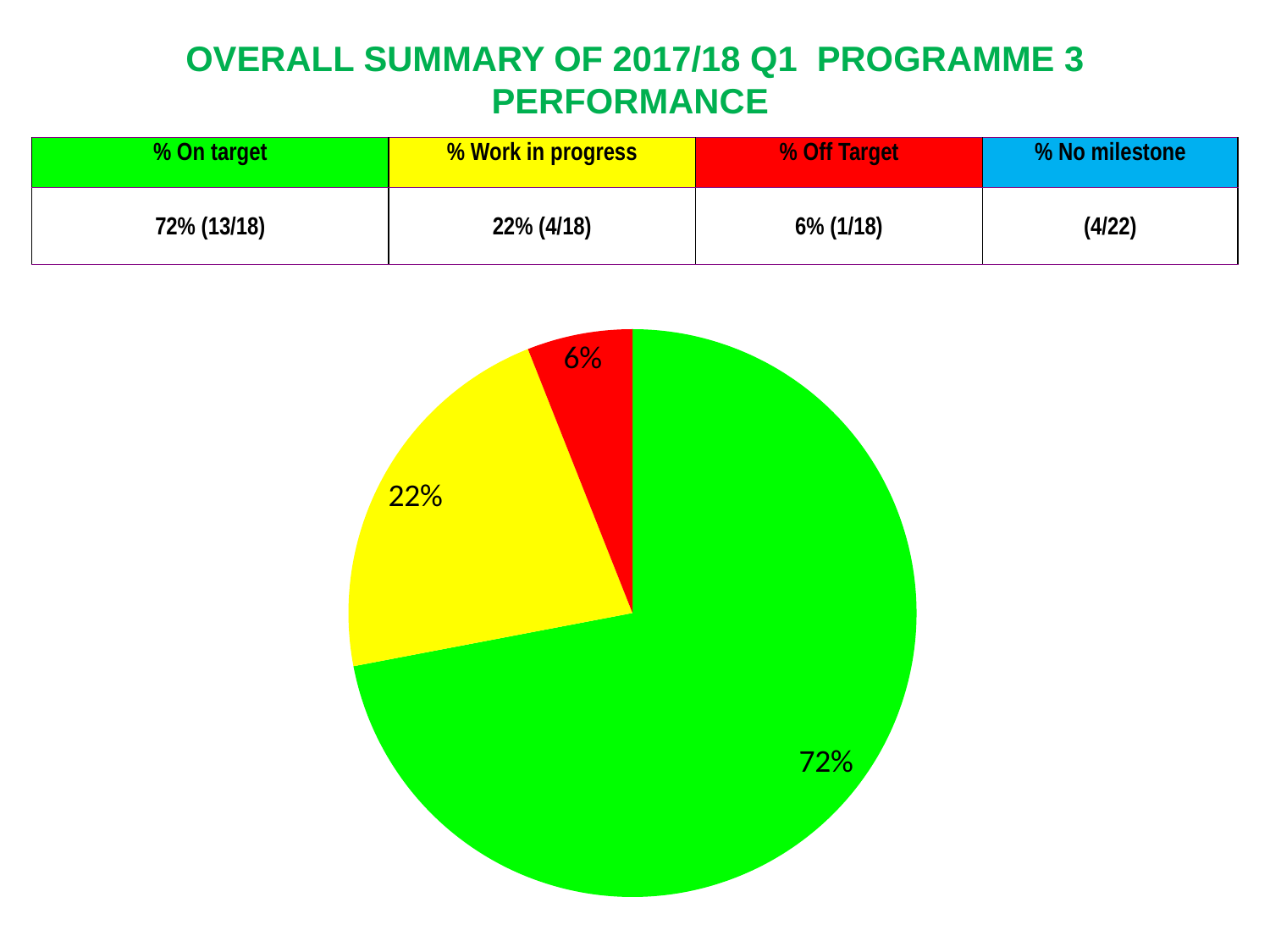
What share of the pie does the red slice represent? 6% What is the difference between the yellow slice and the red slice in the pie chart? 16% Which slice of the pie chart is the largest? 72% (green, On target) What kind of chart is shown on the slide? pie chart How many slices does the pie chart have? 3 Which slice of the pie chart is the smallest? 6% (red, Off Target) According to the table on the slide, which category does the green colour represent? % On target What share of the pie does the yellow slice represent? 22% What is the difference between the green slice and the yellow slice in the pie chart? 50% What is the title of the slide containing the pie chart? OVERALL SUMMARY OF 2017/18 Q1 PROGRAMME 3 PERFORMANCE Which is larger in the pie chart, the yellow slice or the red slice? the yellow slice What share of the pie does the green slice represent? 72%